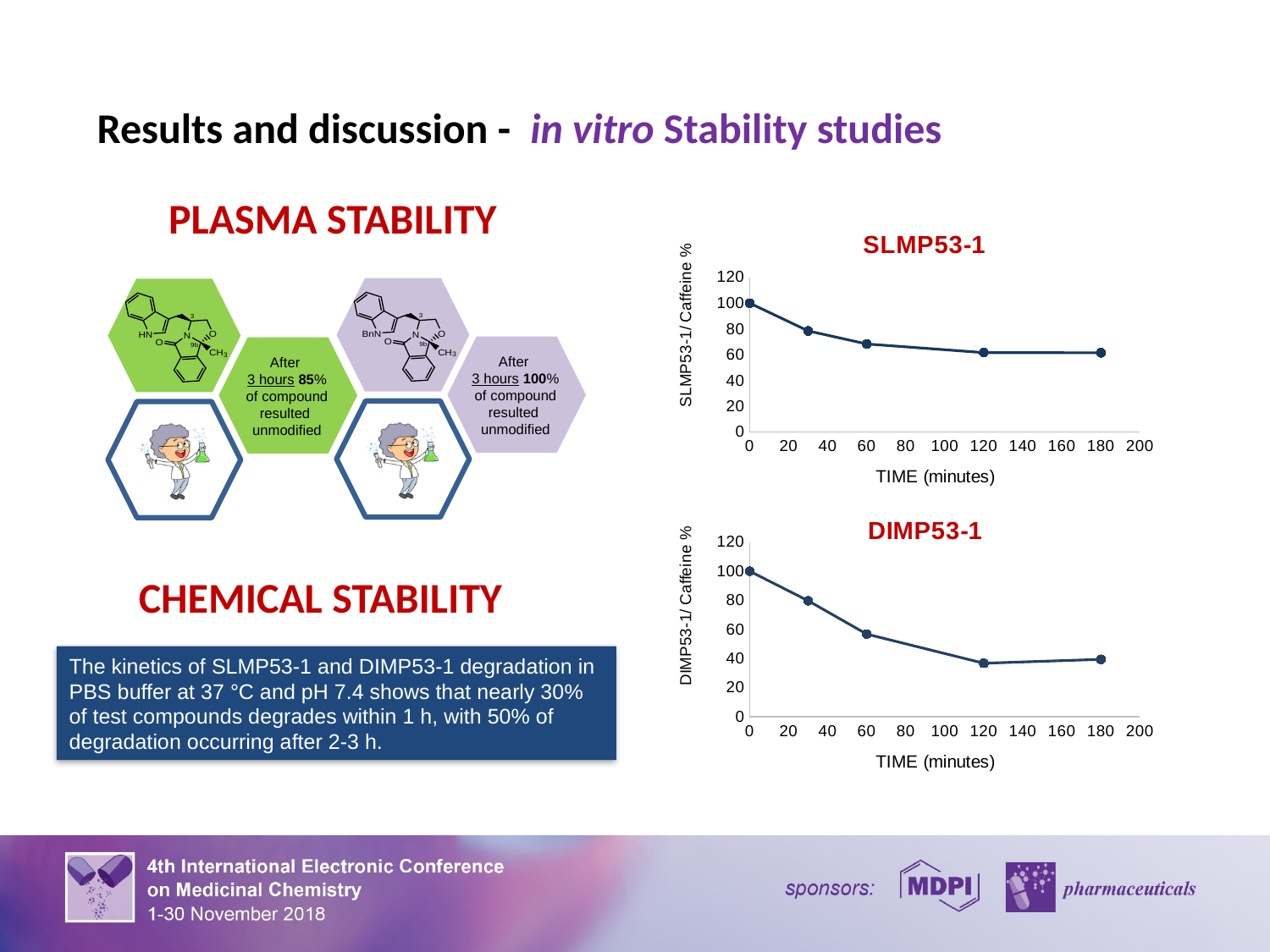
In the DIMP53-1 chart, how many data points are plotted? 5 In the SLMP53-1 chart, is the value at 120 minutes greater or less than 80? less In the DIMP53-1 chart, at which time is the value highest? 0 minutes In the SLMP53-1 chart, do the values rise or fall as time increases? fall What is the x-axis title of the DIMP53-1 chart? TIME (minutes) At 180 minutes, which chart shows the larger value, SLMP53-1 or DIMP53-1? SLMP53-1 In the DIMP53-1 chart, is the value at 60 minutes greater or less than 40? greater In the DIMP53-1 chart, is the value at 120 minutes greater or less than 60? less In the SLMP53-1 chart, how many data points are plotted? 5 What kind of chart is the SLMP53-1 chart? line chart In the SLMP53-1 chart, what is the value at 0 minutes? 100